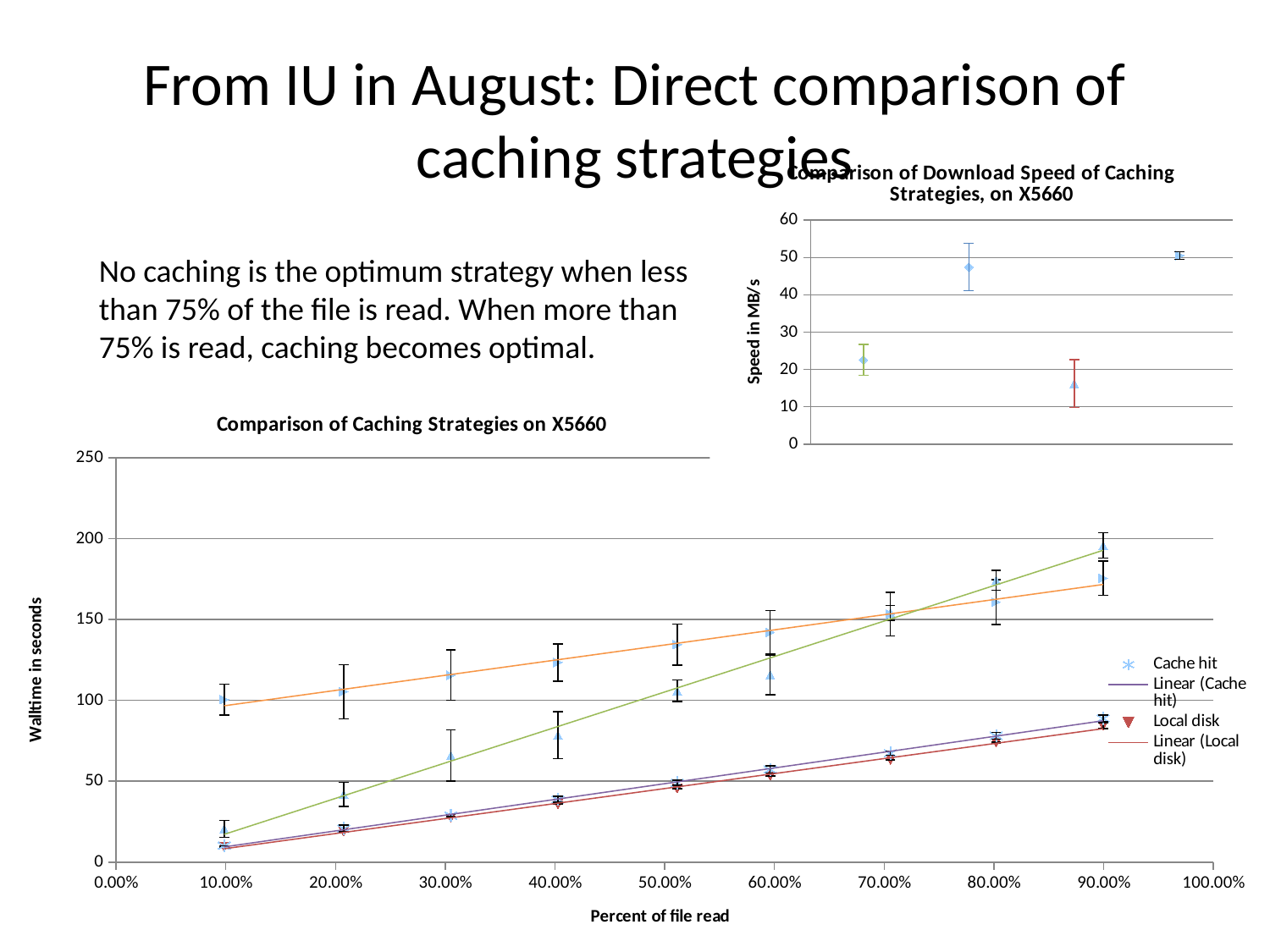
In the chart titled 'Comparison of Caching Strategies on X5660', is the Cache hit value at 10.00% greater or less than 50? less In the chart titled 'Comparison of Caching Strategies on X5660', do the Local disk values rise or fall as the percent of file read increases? rise In the chart titled 'Comparison of Caching Strategies on X5660', what is the label of the vertical axis? Walltime in seconds In the chart titled 'Comparison of Caching Strategies on X5660', at how many percent-of-file-read points are values plotted for the Local disk series? 9 In the chart titled 'Comparison of Caching Strategies on X5660', what is the label of the horizontal axis? Percent of file read In the chart titled 'Comparison of Caching Strategies on X5660', what kind of chart is it? Scatter chart In the chart titled 'Comparison of Download Speed of Caching Strategies, on X5660', is the lowest plotted point greater or less than 20? less In the chart titled 'Comparison of Download Speed of Caching Strategies, on X5660', is the leftmost (green) point greater or less than 30? less In the chart titled 'Comparison of Download Speed of Caching Strategies, on X5660', how many data points are plotted? 4 In the chart titled 'Comparison of Caching Strategies on X5660', how many entries does the legend list? 4 In the chart titled 'Comparison of Download Speed of Caching Strategies, on X5660', what is the label of the vertical axis? Speed in MB/s